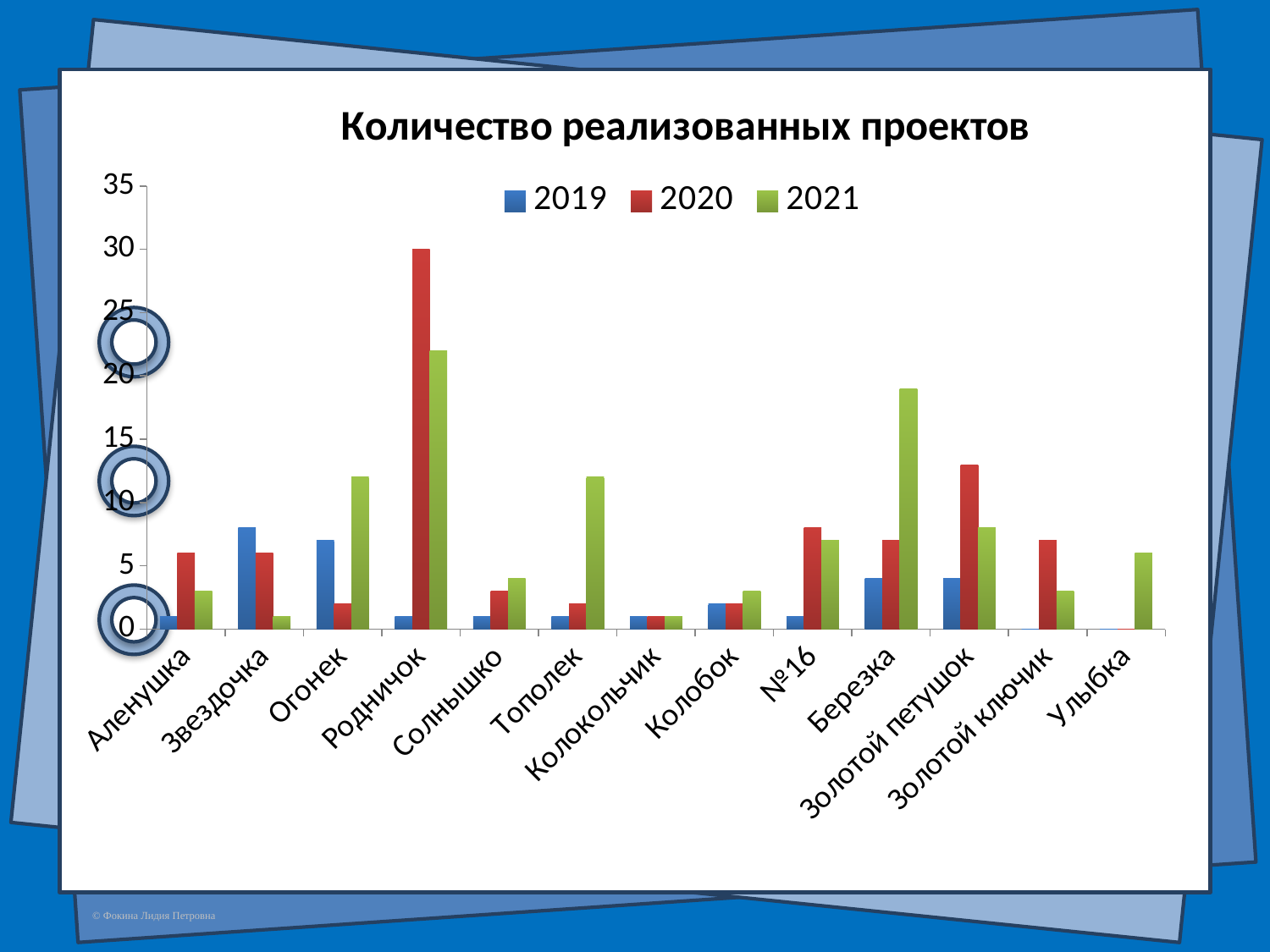
Which category has the highest bar for 2021? Родничок Is the 2021 value for Тополек greater or less than 10? greater What kind of chart is shown on the slide? bar chart Is the 2021 value for Березка greater or less than 15? greater How many categories are shown on the x axis? 13 For Золотой петушок, which is larger: the 2020 value or the 2021 value? 2020 Which colour represents the 2021 series in the legend? green Which category has the highest bar for 2020? Родничок How many series does the legend list? 3 For Звездочка, which is larger: the 2019 value or the 2021 value? 2019 What is the title of the chart? Количество реализованных проектов Is the 2020 value for Родничок greater or less than 25? greater